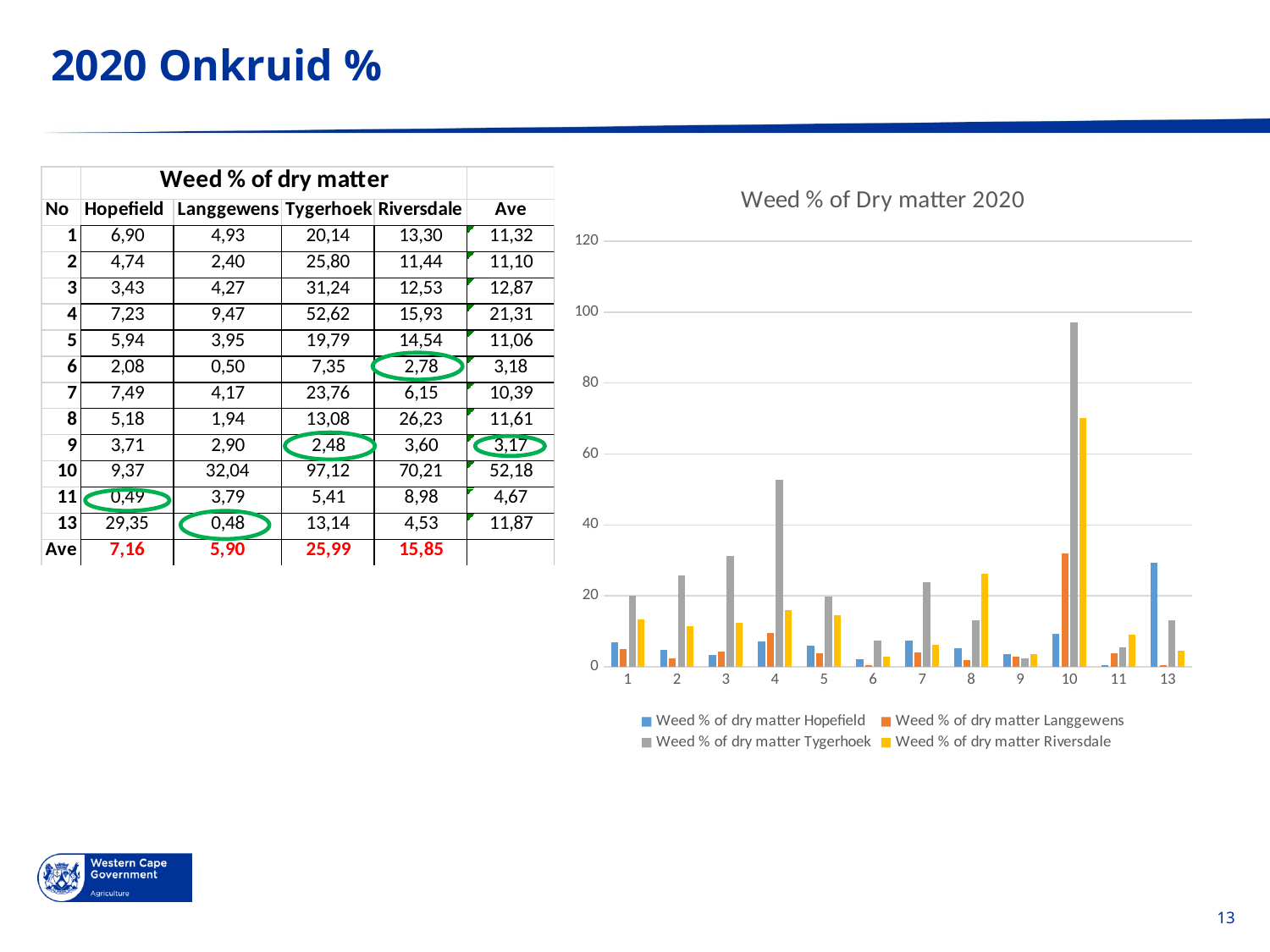
What kind of chart is shown on the slide? Bar chart Is the Riversdale value for category 10 greater or less than 60? greater How many categories are shown along the x axis of the chart? 12 What is the title of the chart? Weed % of Dry matter 2020 What colour represents the Riversdale series in the chart? Yellow How many series does the chart legend list? 4 Which category on the x axis has the tallest bar in the chart? 10 At category 8, which is larger: the Riversdale value or the Tygerhoek value? Riversdale Is the Tygerhoek value for category 4 greater or less than 40? greater For the Hopefield series, which category has the highest value? 13 Is the Tygerhoek value for category 10 greater or less than 80? greater At category 13, which is larger: the Hopefield value or the Tygerhoek value? Hopefield